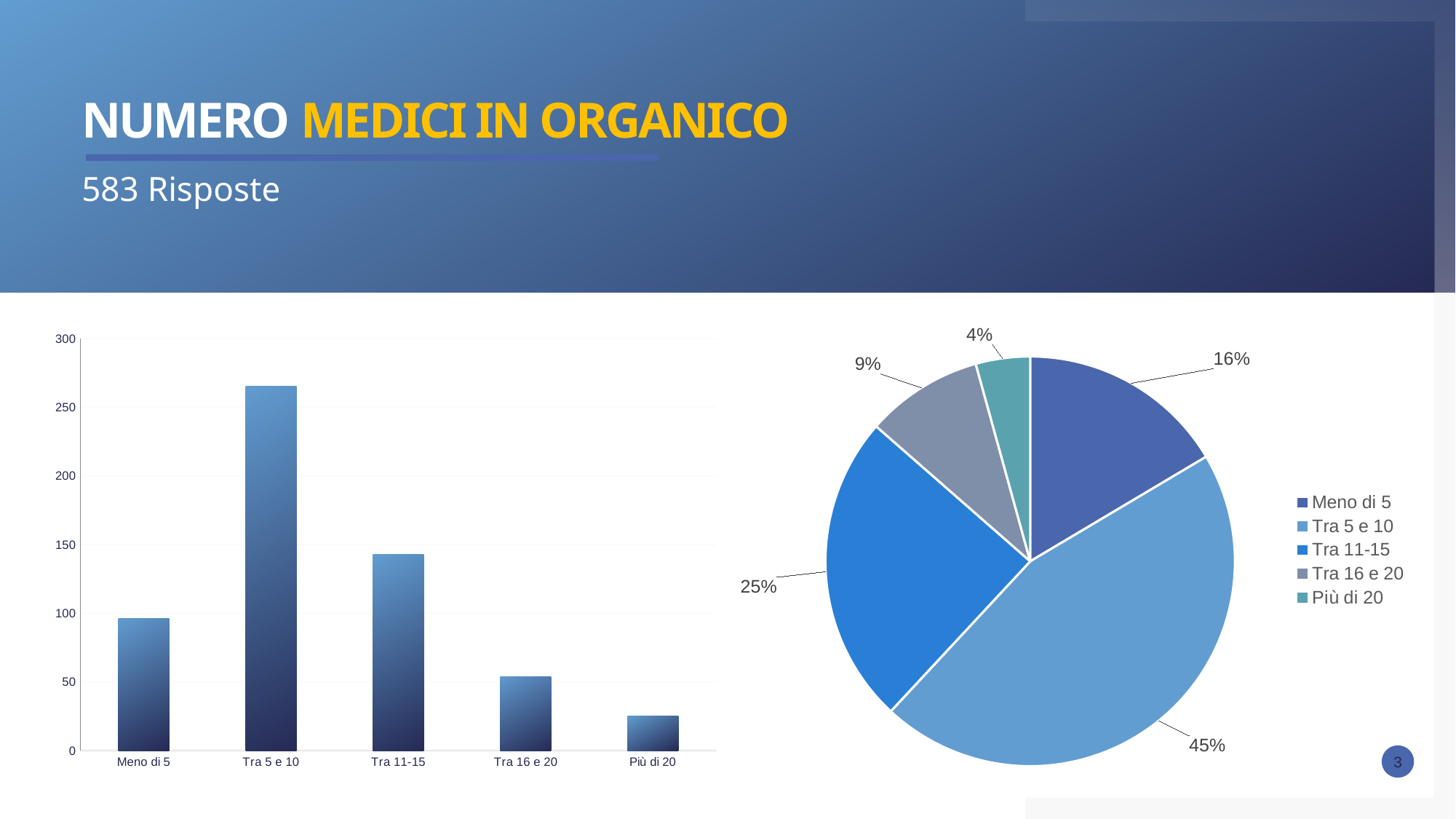
In the bar chart on the left, which category has the lowest bar? Più di 20 What kind of chart is the chart on the left of the slide? bar chart In the bar chart on the left, which is larger, the bar for Tra 11-15 or the bar for Meno di 5? Tra 11-15 In the pie chart on the right, what share does the Tra 5 e 10 slice have? 45% In the pie chart on the right, what is the difference between the Tra 11-15 share and the Tra 16 e 20 share? 16% How many entries does the legend of the pie chart on the right list? 5 In the bar chart on the left, which category has the highest bar? Tra 5 e 10 In the bar chart on the left, how many categories are shown on the x axis? 5 In the bar chart on the left, is the value for Tra 5 e 10 greater or less than 250? greater What kind of chart is the chart on the right of the slide? pie chart